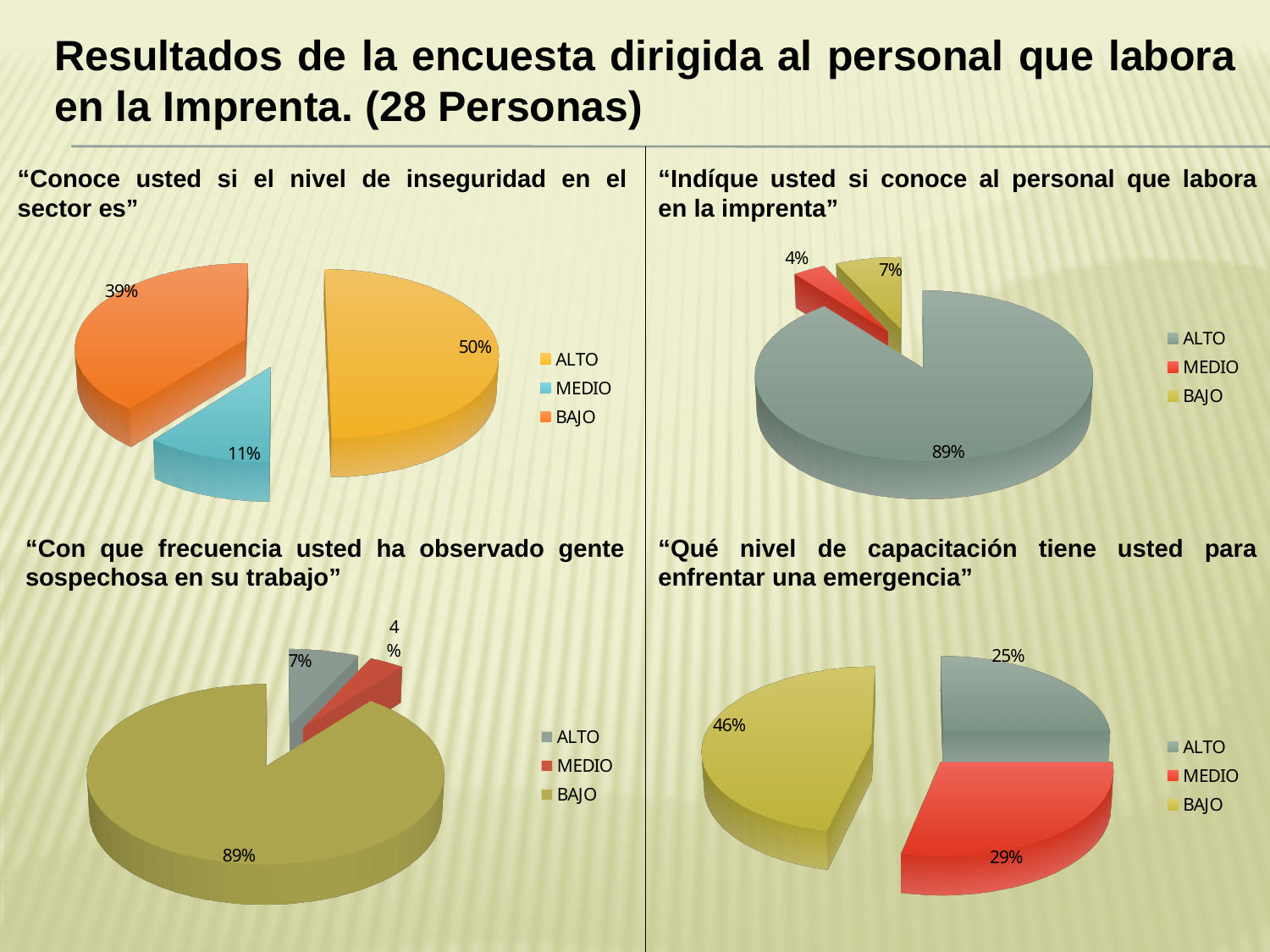
In the bottom-left pie chart ("Con que frecuencia usted ha observado gente sospechosa en su trabajo"), what percentage is shown for BAJO? 89% What type of chart is used for "Indíque usted si conoce al personal que labora en la imprenta" in the top-right of the slide? Pie chart In the top-left pie chart ("Conoce usted si el nivel de inseguridad en el sector es"), what is the difference in percentage points between ALTO and BAJO? 11 In the top-right pie chart ("Indíque usted si conoce al personal que labora en la imprenta"), which category has the smallest share? MEDIO In the bottom-right pie chart ("Qué nivel de capacitación tiene usted para enfrentar una emergencia"), which category has the largest share? BAJO In the top-left pie chart ("Conoce usted si el nivel de inseguridad en el sector es"), which category has the smallest share? MEDIO How many categories does the legend of the bottom-right pie chart ("Qué nivel de capacitación tiene usted para enfrentar una emergencia") list? 3 In the bottom-right pie chart ("Qué nivel de capacitación tiene usted para enfrentar una emergencia"), what percentage is shown for MEDIO? 29% In the top-left pie chart ("Conoce usted si el nivel de inseguridad en el sector es"), what percentage is shown for MEDIO? 11% In the top-left pie chart ("Conoce usted si el nivel de inseguridad en el sector es"), what percentage is shown for ALTO? 50% In the bottom-left pie chart ("Con que frecuencia usted ha observado gente sospechosa en su trabajo"), which is larger, ALTO or MEDIO? ALTO In the top-right pie chart ("Indíque usted si conoce al personal que labora en la imprenta"), what percentage is shown for ALTO? 89%